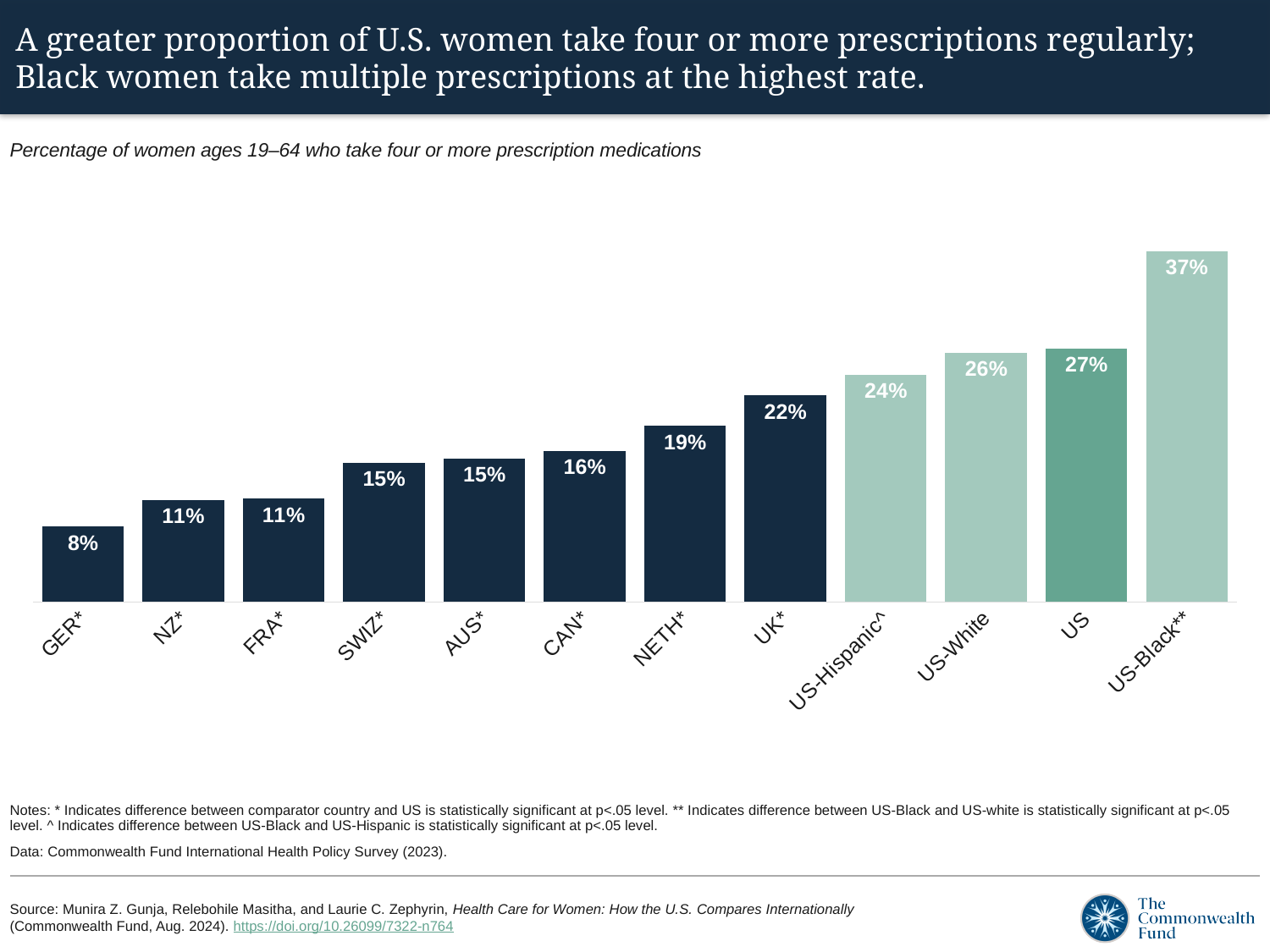
What is the subtitle describing what the chart measures? Percentage of women ages 19–64 who take four or more prescription medications What is the difference in percentage points between the US and GER? 19 What percentage of women ages 19–64 in the UK take four or more prescription medications? 22% What is the value shown for US-Hispanic? 24% Do the values generally rise or fall moving from left to right along the x axis? Rise What kind of chart is shown on the slide? Bar chart How many categories are shown on the x axis? 12 What is the difference in percentage points between US-Black and US-White? 11 What is the value shown for GER? 8% Which category has the lowest percentage? GER Which category has the highest percentage of women taking four or more prescription medications? US-Black Which has a higher value, NETH or CAN? NETH